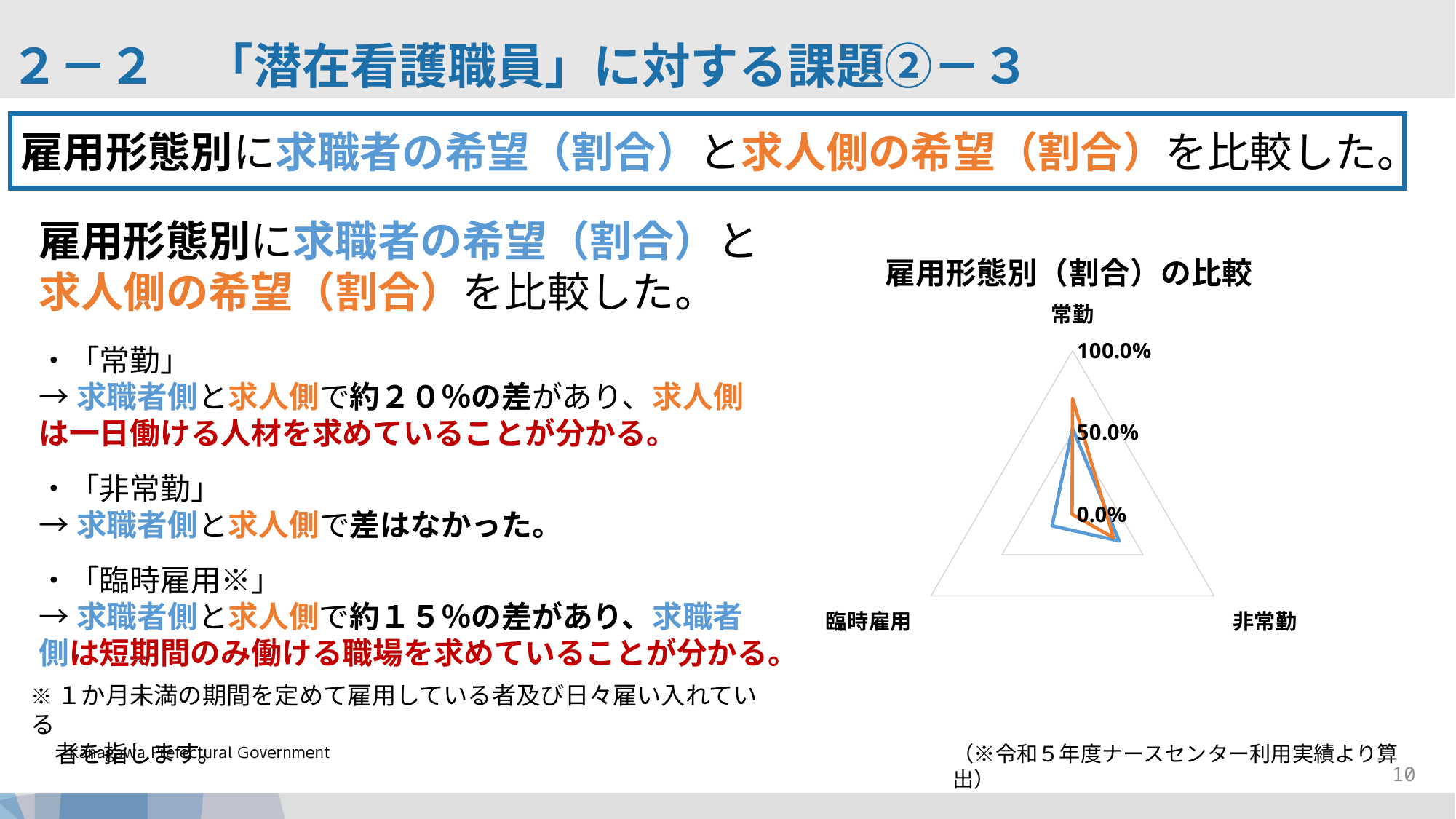
For 臨時雇用, which series has the larger value, the blue (求職者) or the orange (求人側)? Blue (求職者) How many data series (lines) are plotted on the radar chart? 2 Is the orange (求人側) value for 臨時雇用 greater or less than 50.0%? less For 常勤, which series has the larger value, the blue (求職者) or the orange (求人側)? Orange (求人側) What is the title of the chart on the slide? 雇用形態別（割合）の比較 What kind of chart is shown on the slide? Radar chart How many employment-type categories (axes) does the radar chart have? 3 What is the maximum value shown on the radar chart's axis scale? 100.0% Is the blue (求職者) value for 非常勤 greater or less than 50.0%? less Is the orange (求人側) value for 常勤 greater or less than 50.0%? greater For the orange (求人側) series, which employment type has the highest value? 常勤 For the orange (求人側) series, which employment type has the lowest value? 臨時雇用